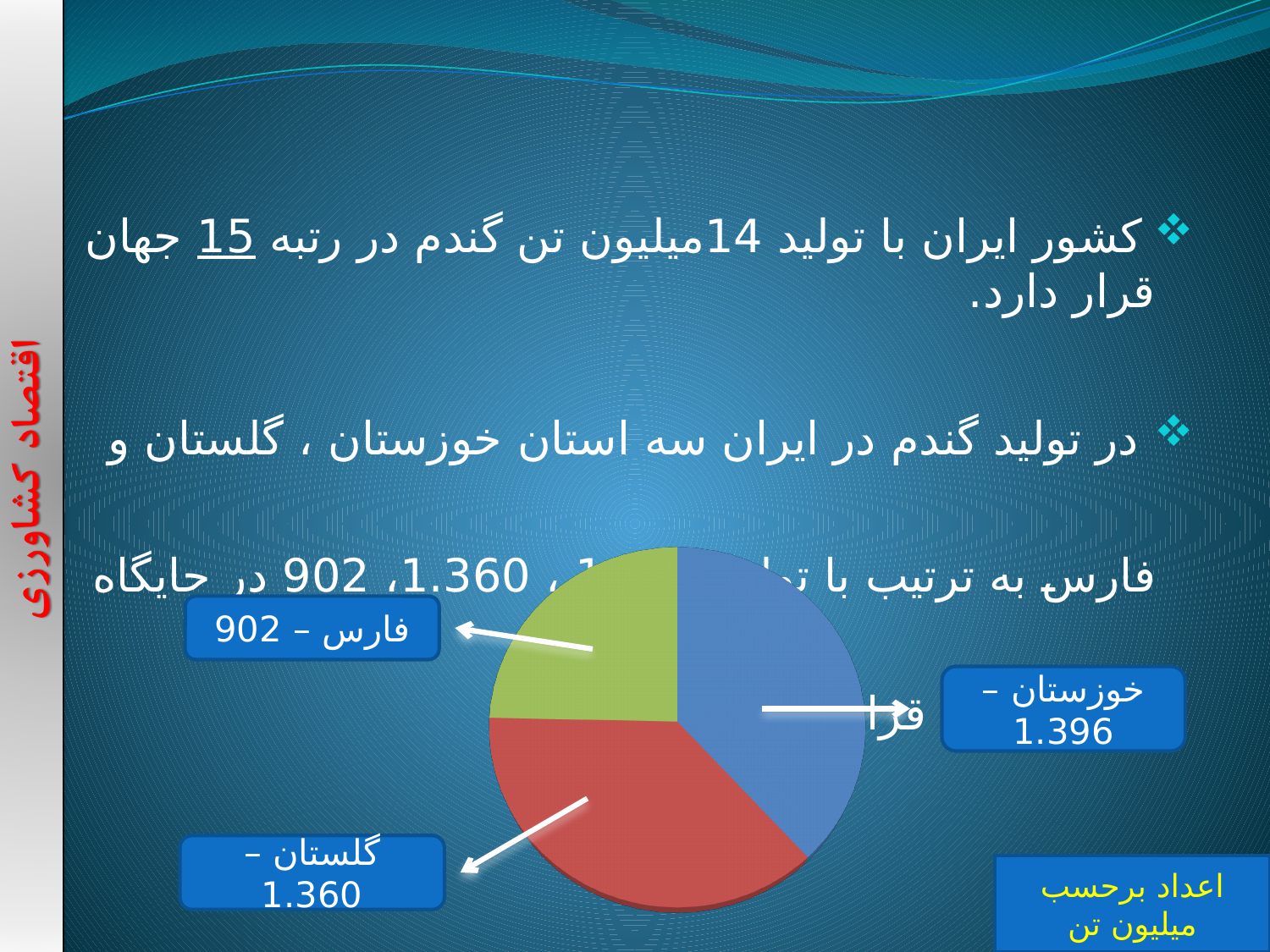
What is the difference between the labelled values for Khuzestan and Golestan? 0.036 Which province has the highest labelled value on the pie chart? Khuzestan (خوزستان) Which province has the lowest labelled value on the pie chart? Fars (فارس) According to the note on the slide, what unit are the chart's numbers given in? million tons (میلیون تن) Which labelled value is larger on the pie chart, Khuzestan or Golestan? Khuzestan What value is labelled for Khuzestan (خوزستان) on the pie chart? 1.396 What value is labelled for Fars (فارس) on the pie chart? 902 Which colour is the Fars (فارس) slice of the pie chart? green What value is labelled for Golestan (گلستان) on the pie chart? 1.360 What kind of chart is shown on the slide? pie chart How many slices does the pie chart have? 3